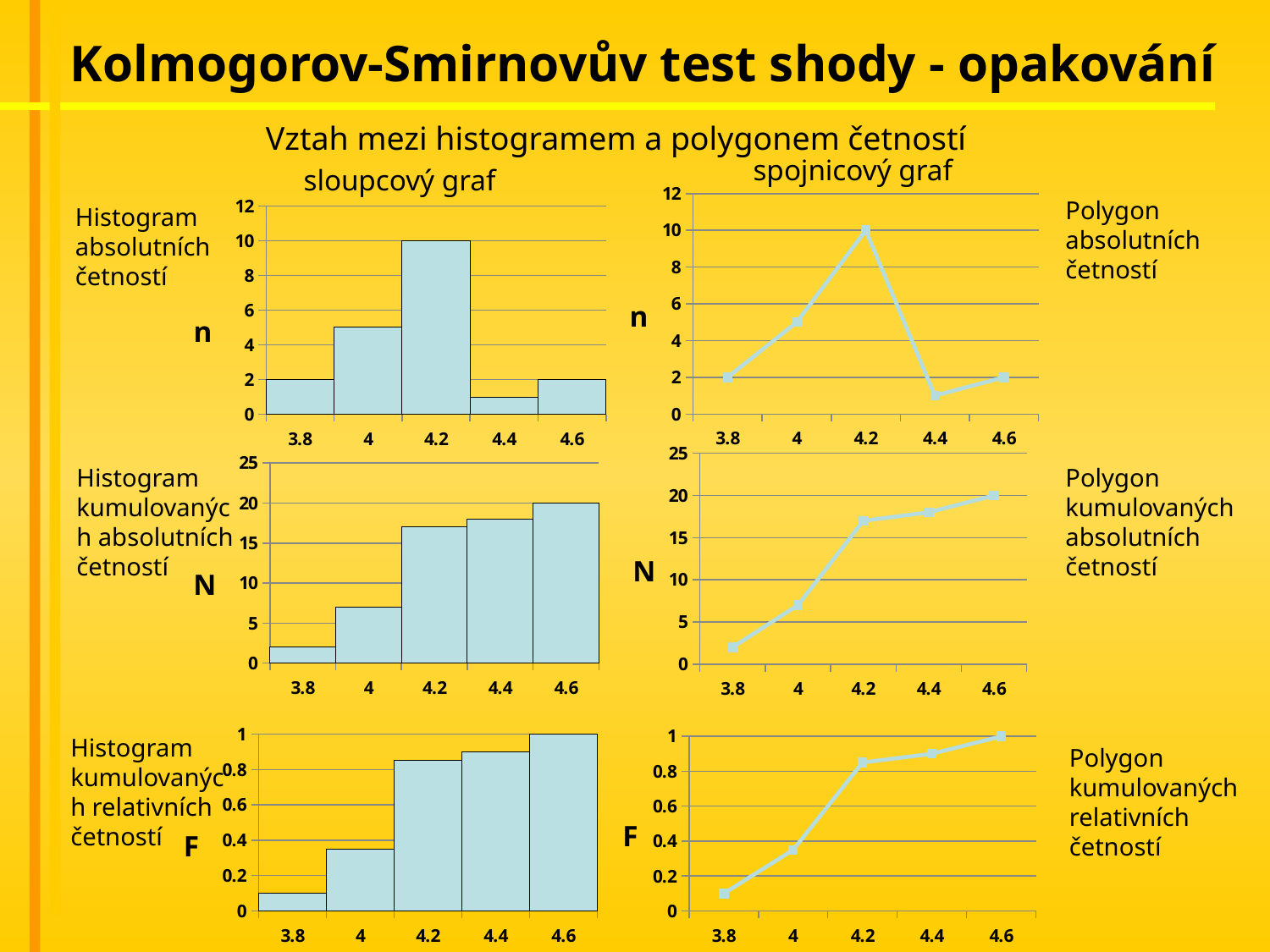
In the top-left histogram of absolute frequencies, which category has the lowest bar? 4.4 In the top-left histogram of absolute frequencies, which category has the highest bar? 4.2 In the middle-right polygon of cumulative absolute frequencies, do the values rise or fall from 3.8 to 4.6? rise In the middle-left histogram of cumulative absolute frequencies, is the value for 4.2 greater or less than 15? greater How many categories are shown on the x axis of the top-left histogram? 5 In the top-right polygon of absolute frequencies, is the value at 4.4 greater or less than 2? less What kind of chart is the bottom-right chart (Polygon kumulovaných relativních četností)? line chart In the bottom-left histogram of cumulative relative frequencies, what is the value for 4.6? 1 In the top-left histogram of absolute frequencies (Histogram absolutních četností), what is the value for 4.2? 10 In the top-right polygon of absolute frequencies (Polygon absolutních četností), what is the value at 4.2? 10 In the top-left histogram of absolute frequencies, what is the value for 3.8? 2 In the middle-right polygon of cumulative absolute frequencies (Polygon kumulovaných absolutních četností), what is the value at 4.6? 20